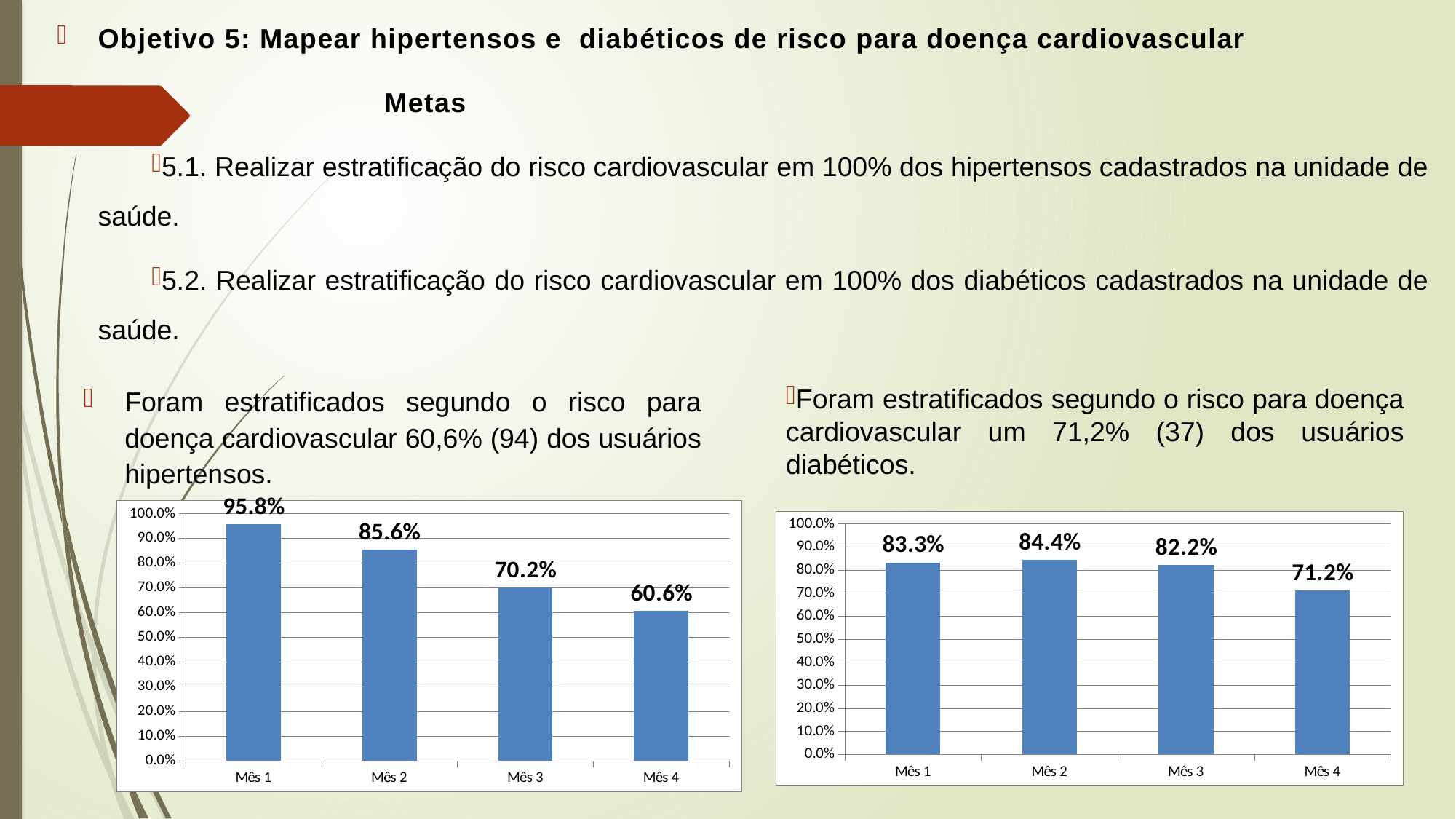
In the left chart (hipertensos), which is larger, the value for Mês 2 or Mês 3? Mês 2 In the right chart (diabéticos), what is the difference between the values for Mês 3 and Mês 4? 11.0% In the left chart (hipertensos), what is the value for Mês 4? 60.6% In the left chart (hipertensos), do the values rise or fall from Mês 1 to Mês 4? fall What kind of chart is the left chart (hipertensos)? bar chart In the right chart (diabéticos), what is the value for Mês 2? 84.4% In the left chart (hipertensos), what is the value for Mês 1? 95.8% In the left chart (hipertensos), what is the difference between the values for Mês 1 and Mês 4? 35.2% In the left chart (hipertensos), which month has the highest value? Mês 1 How many categories (months) does the right chart (diabéticos) show? 4 In the right chart (diabéticos), which month has the lowest value? Mês 4 In the right chart (diabéticos), what is the value for Mês 4? 71.2%